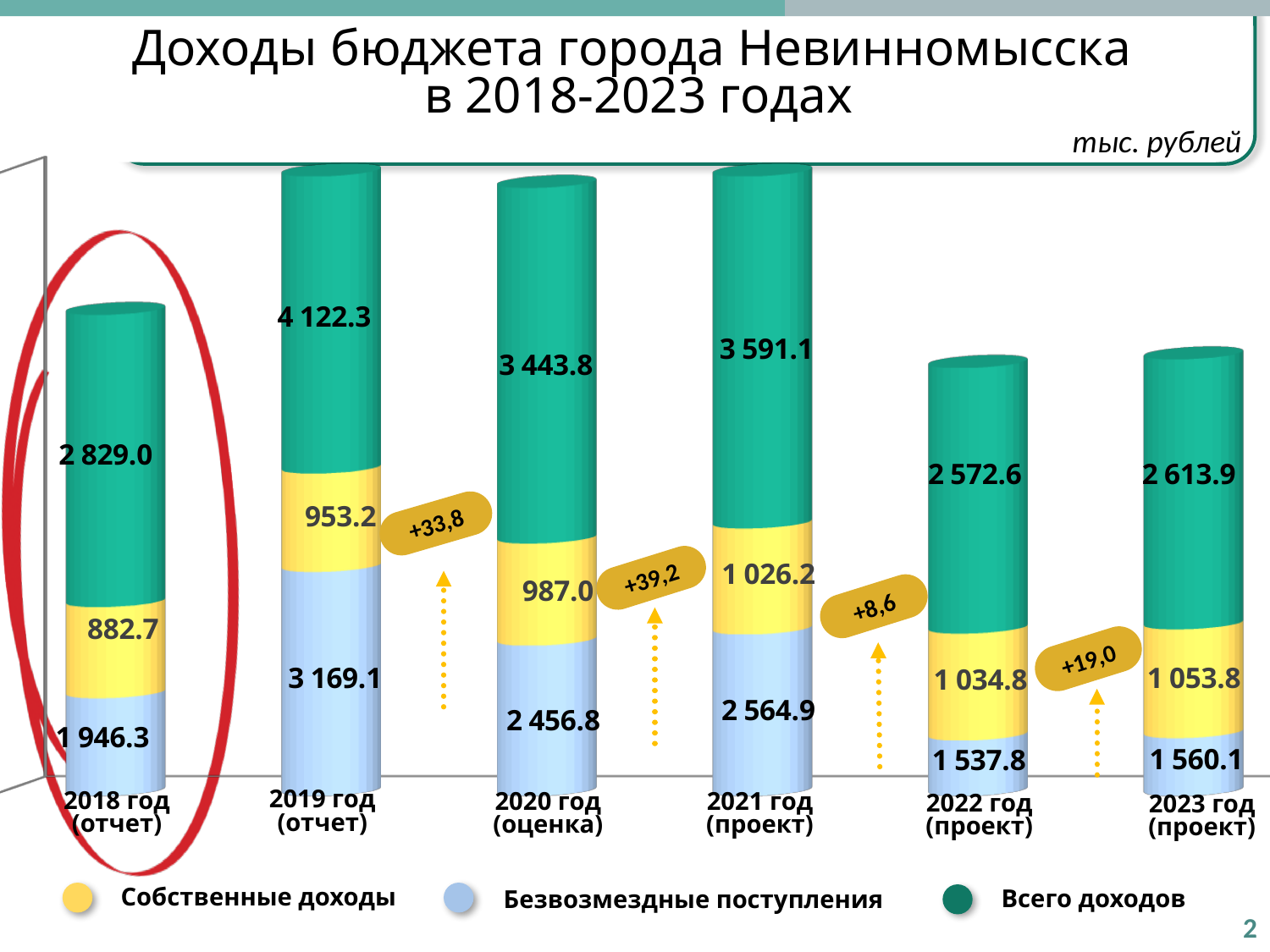
Which year has the larger value of Безвозмездные поступления: 2020 год (оценка) or 2021 год (проект)? 2021 год (проект) What is the difference between Собственные доходы in 2023 год (проект) and 2022 год (проект)? 19.0 What is the value of Собственные доходы for 2018 год (отчет)? 882.7 In which year is Всего доходов the highest? 2019 год (отчет) What is the value of Всего доходов for 2019 год (отчет)? 4 122.3 What is the value of Безвозмездные поступления for 2022 год (проект)? 1 537.8 In which year is Собственные доходы the lowest? 2018 год (отчет) How many series does the legend list? 3 What unit of measurement is indicated on the slide for the chart values? тыс. рублей What type of chart is shown on the slide? bar chart How many years (categories) are shown on the x axis? 6 Do the values of Собственные доходы rise or fall from 2018 to 2023? rise